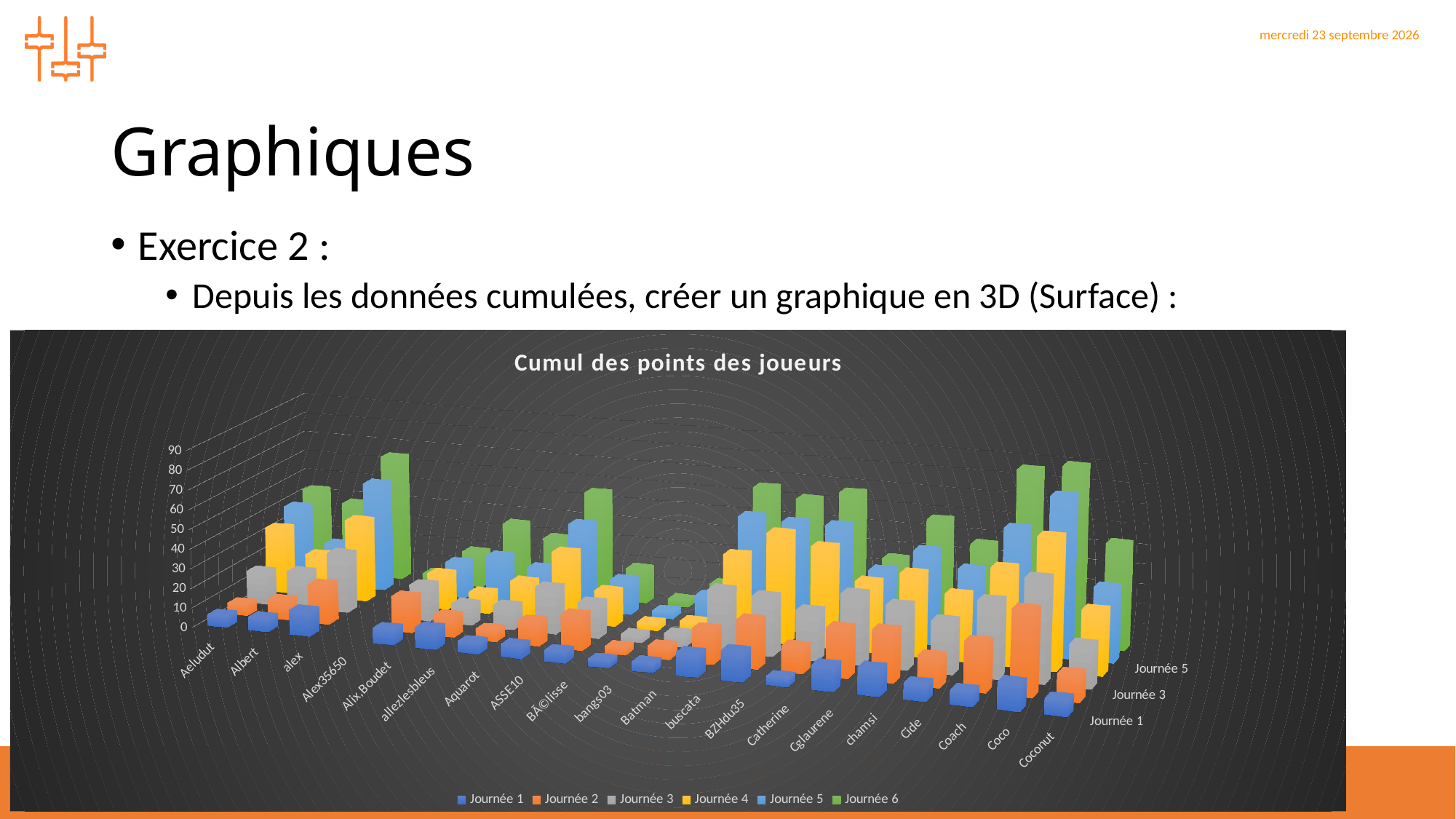
What is the highest value shown on the vertical axis? 90 Is the Journée 6 value for Coco greater or less than 40? greater Is the Journée 6 value for Batman greater or less than 50? less What is the title of the chart? Cumul des points des joueurs Which is larger, the Journée 6 value for Coco or for Aeludut? Coco What kind of chart is shown on the slide? bar chart How many player categories are shown along the x axis? 20 Which colour represents Journée 6 in the legend? green How many series does the legend list? 6